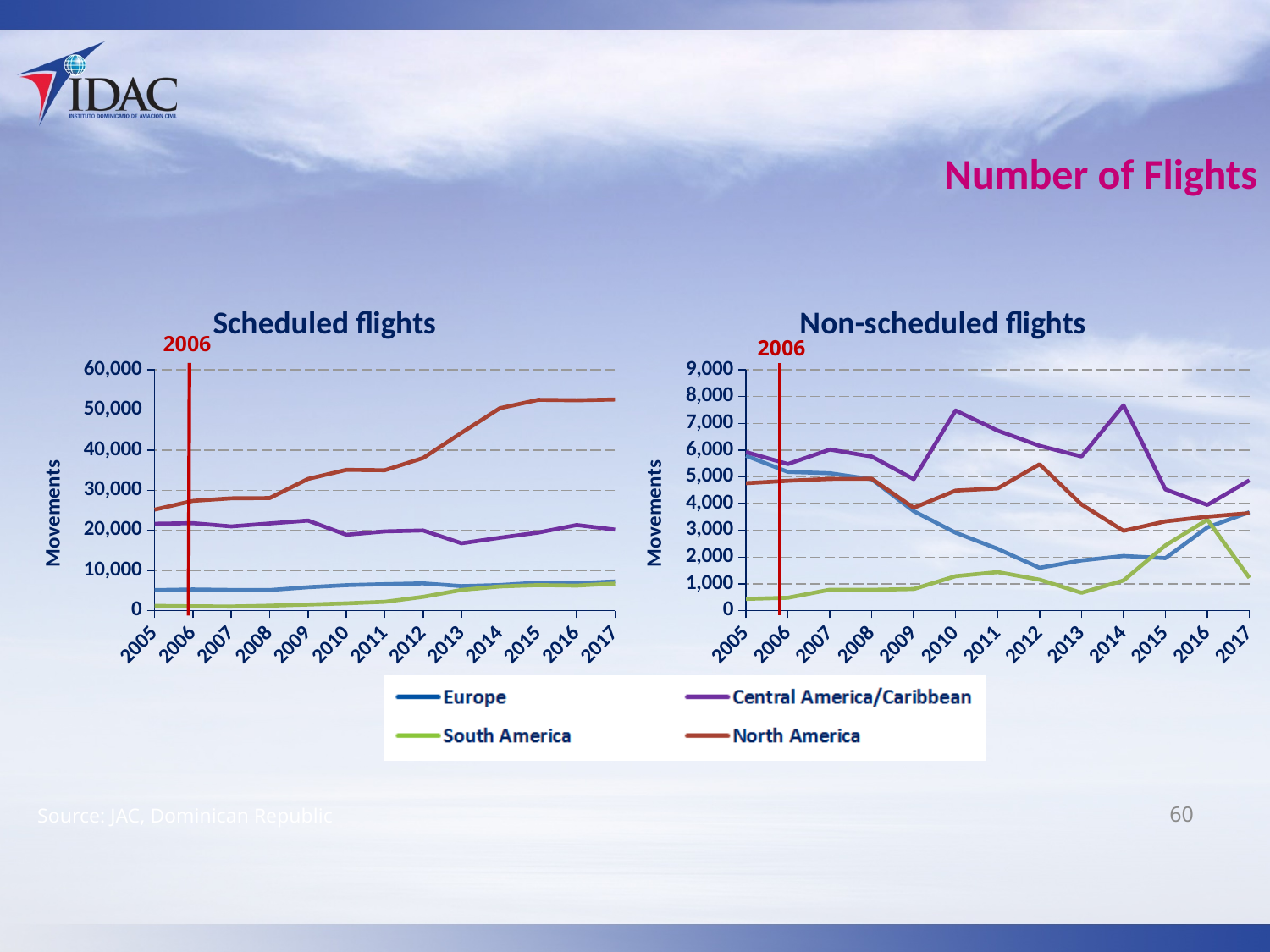
In the Non-scheduled flights chart, is the value for Central America/Caribbean in 2014 greater or less than 7,000? greater In the Non-scheduled flights chart, does the Europe line rise or fall from 2005 to 2012? fall In the Scheduled flights chart, which series has the highest value in 2017? North America In the Scheduled flights chart, is the value for North America in 2017 greater or less than 50,000? greater How many years are shown on the x axis of the Non-scheduled flights chart? 13 How many series does the shared legend list? 4 Which year is marked by the red vertical line on both charts? 2006 In the Non-scheduled flights chart, which series has the highest value in 2014? Central America/Caribbean What kind of chart is the Scheduled flights chart? line chart In the Scheduled flights chart, which is larger in 2010: North America or Central America/Caribbean? North America In the Scheduled flights chart, does the North America line rise or fall from 2005 to 2017? rise In the Non-scheduled flights chart, which series has the lowest value in 2017? South America